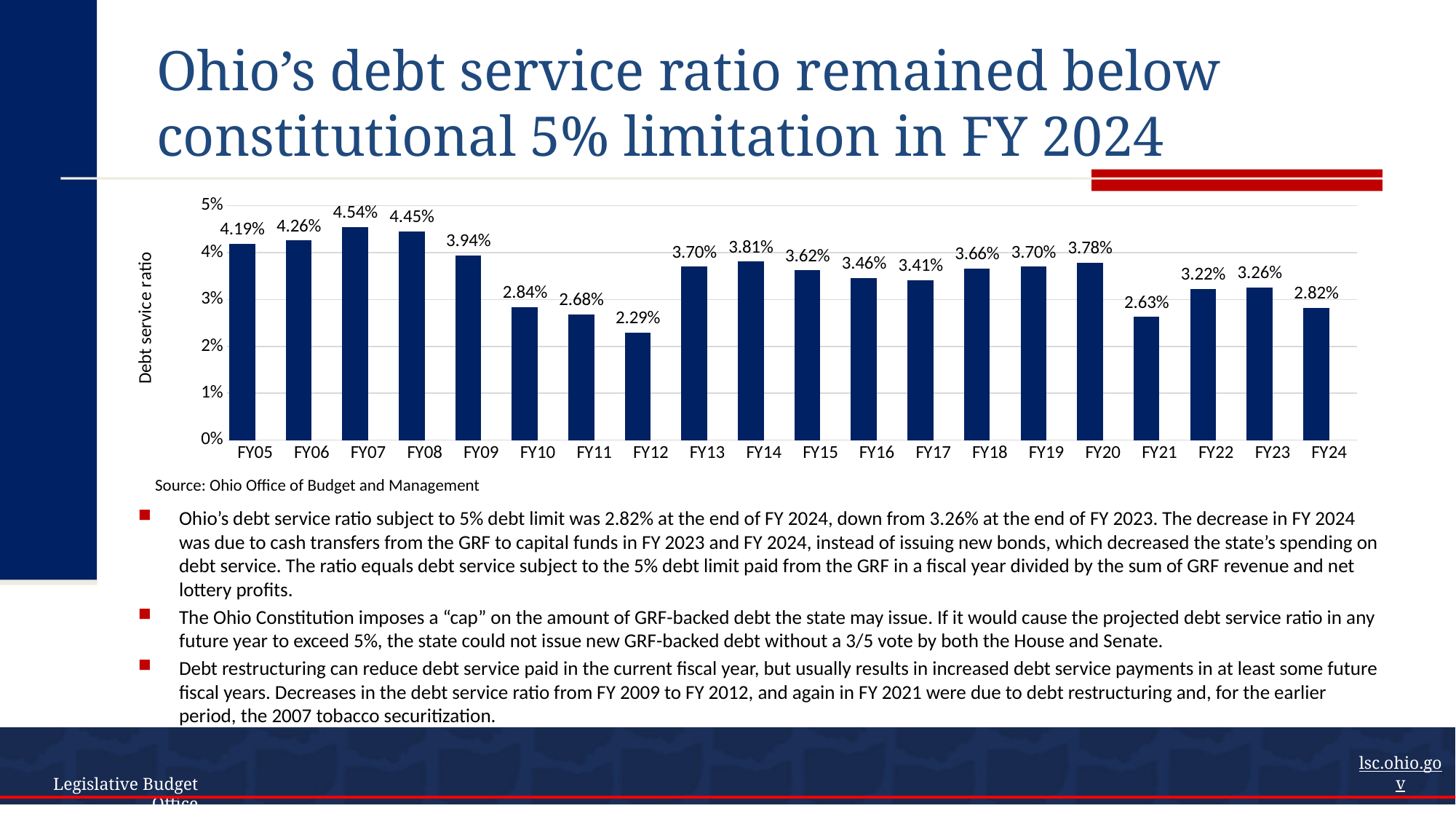
What is the debt service ratio for FY12? 2.29% What is the debt service ratio for FY24? 2.82% How many fiscal years are shown in the chart? 20 What is the label on the vertical axis of the chart? Debt service ratio Which fiscal year has the lowest debt service ratio? FY12 What is the debt service ratio for FY07? 4.54% What kind of chart is shown on the slide? bar chart Is the debt service ratio for FY08 greater or less than 4%? greater Did the debt service ratio rise or fall from FY09 to FY12? fall What is the difference between the debt service ratio in FY23 and FY24? 0.44% Which is larger, the debt service ratio in FY20 or FY21? FY20 Which fiscal year has the highest debt service ratio? FY07